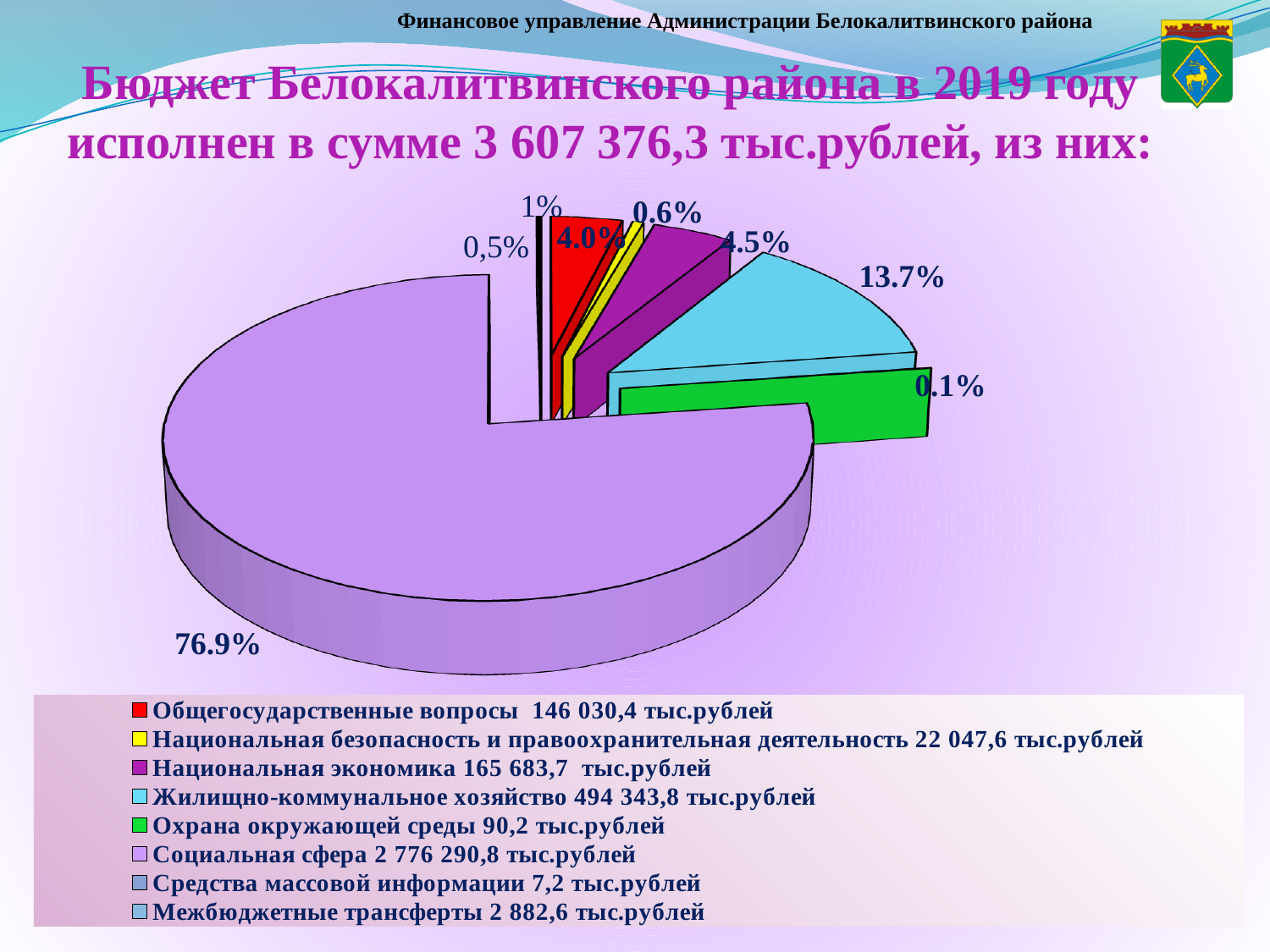
What is the value shown in the legend for Межбюджетные трансферты? 2 882,6 тыс.рублей What share of the pie does Социальная сфера account for? 76.9% What is the value shown in the legend for Жилищно-коммунальное хозяйство? 494 343,8 тыс.рублей What colour is the slice for Общегосударственные вопросы? Red How many categories does the legend of the pie chart list? 8 What share of the pie does Жилищно-коммунальное хозяйство account for? 13.7% What kind of chart is shown on the slide? Pie chart Which category has the smallest value in the legend? Средства массовой информации Which category has the largest slice of the pie chart? Социальная сфера What is the value shown in the legend for Охрана окружающей среды? 90,2 тыс.рублей What is the difference between the values for Национальная экономика and Общегосударственные вопросы? 19 653,3 тыс.рублей Which is larger: Национальная экономика or Общегосударственные вопросы? Национальная экономика